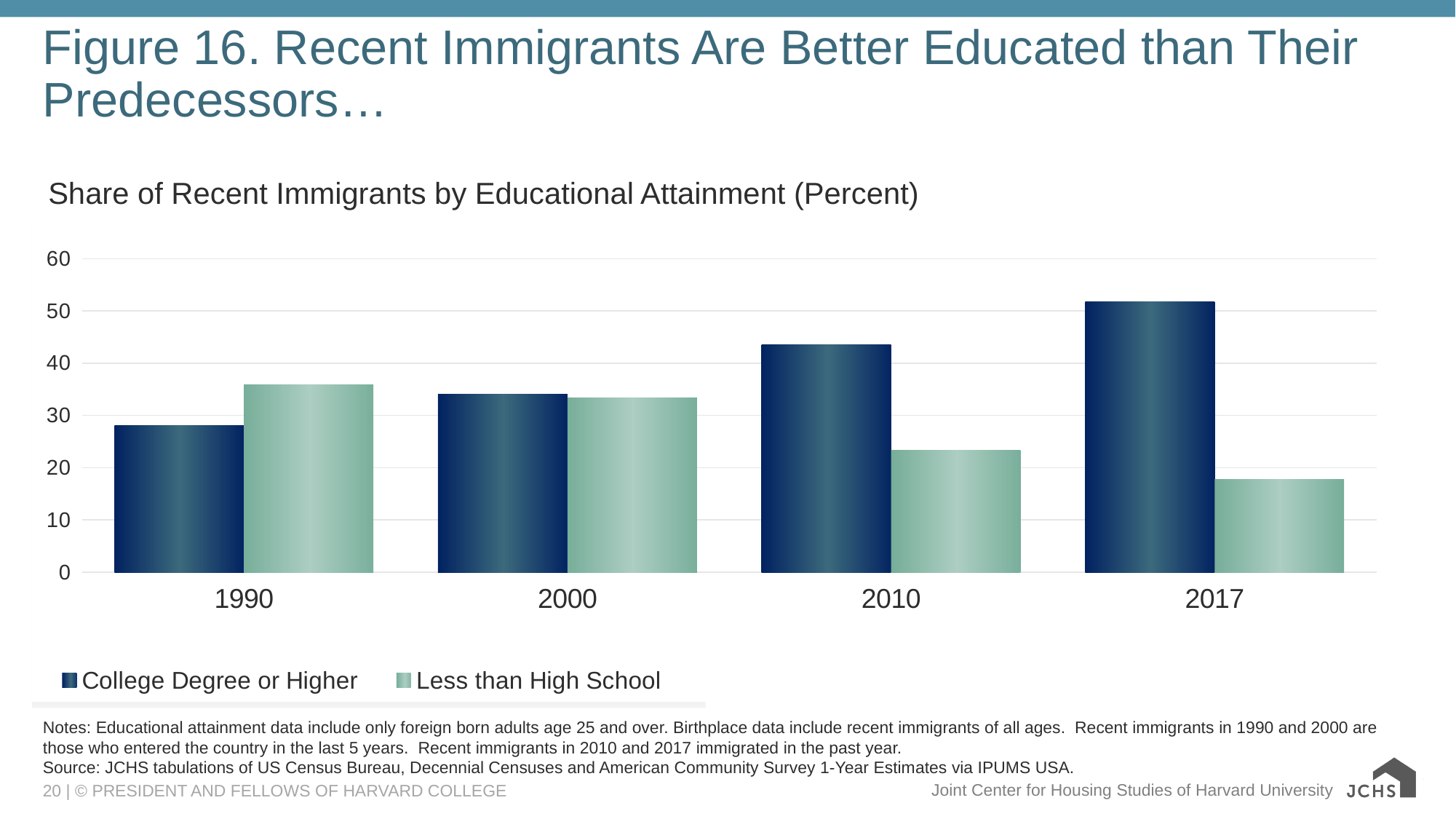
In 2010, which is larger: the share with a College Degree or Higher or the share with Less than High School? College Degree or Higher What kind of chart is shown on the slide? Bar chart In 1990, which is larger: the share with a College Degree or Higher or the share with Less than High School? Less than High School In which year is the share of recent immigrants with Less than High School the highest? 1990 How many years are shown on the x axis? 4 Does the share of recent immigrants with a College Degree or Higher rise or fall from 1990 to 2017? Rise What is the subtitle of the chart? Share of Recent Immigrants by Educational Attainment (Percent) In which year is the share of recent immigrants with a College Degree or Higher the highest? 2017 Is the value for Less than High School in 2017 greater or less than 20? less In which year is the share of recent immigrants with Less than High School the lowest? 2017 Is the value for College Degree or Higher in 2010 greater or less than 40? greater How many series does the legend list? 2